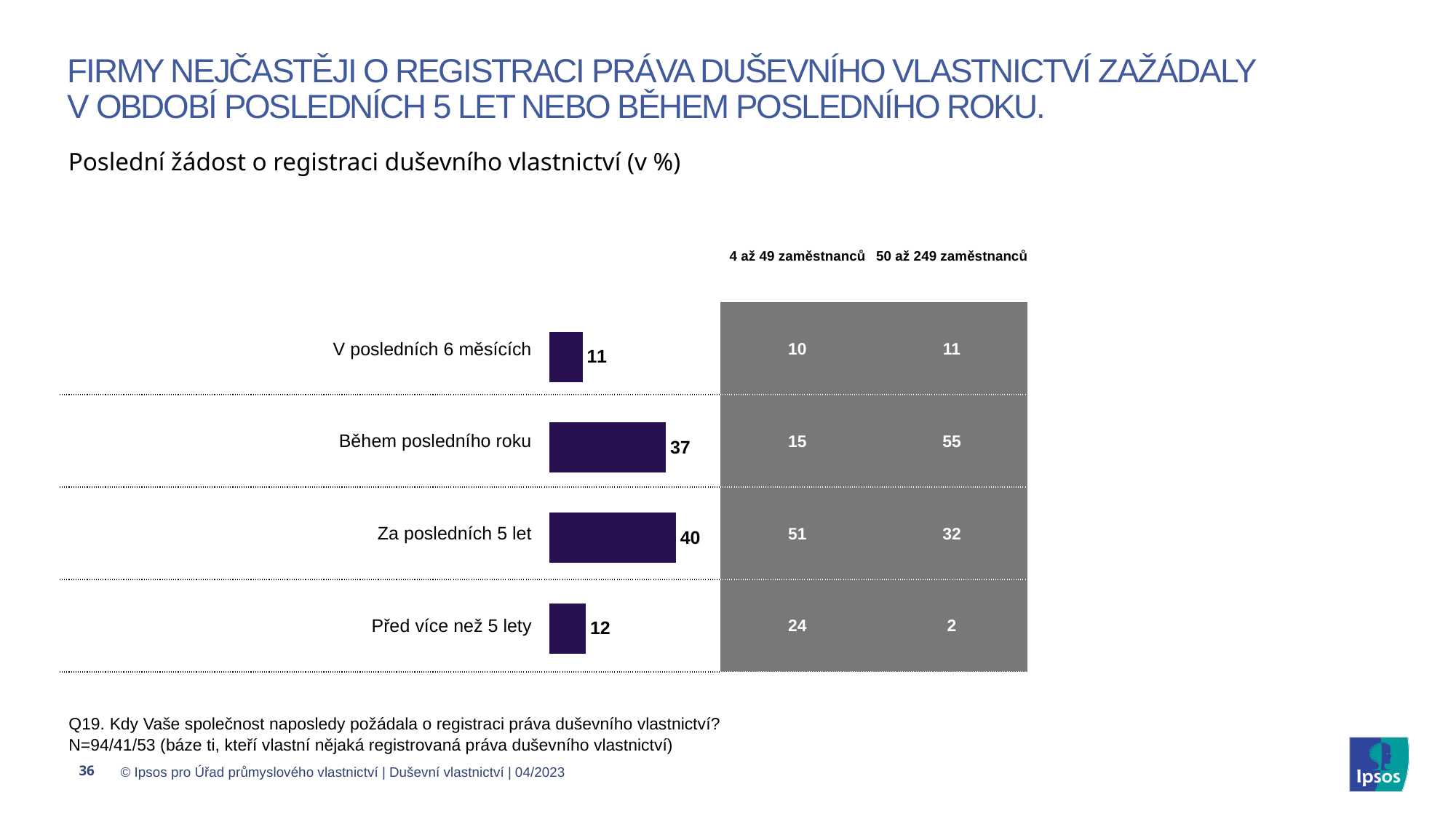
In the table next to the chart, what is the value for "Během posledního roku" in the "50 až 249 zaměstnanců" column? 55 Which category has the lowest value in the bar chart? V posledních 6 měsících What is the difference between the values for "Za posledních 5 let" and "Během posledního roku" in the bar chart? 3 How many categories are shown in the bar chart? 4 Which is larger in the bar chart: the value for "Před více než 5 lety" or the value for "Během posledního roku"? Během posledního roku What is the value for "Za posledních 5 let" in the bar chart? 40 What is the value for "V posledních 6 měsících" in the bar chart? 11 What type of chart is shown on the slide? Bar chart Which category has the highest value in the bar chart? Za posledních 5 let What is the subtitle of the chart on the slide? Poslední žádost o registraci duševního vlastnictví (v %) What is the value for "Před více než 5 lety" in the bar chart? 12 What is the value for "Během posledního roku" in the bar chart? 37